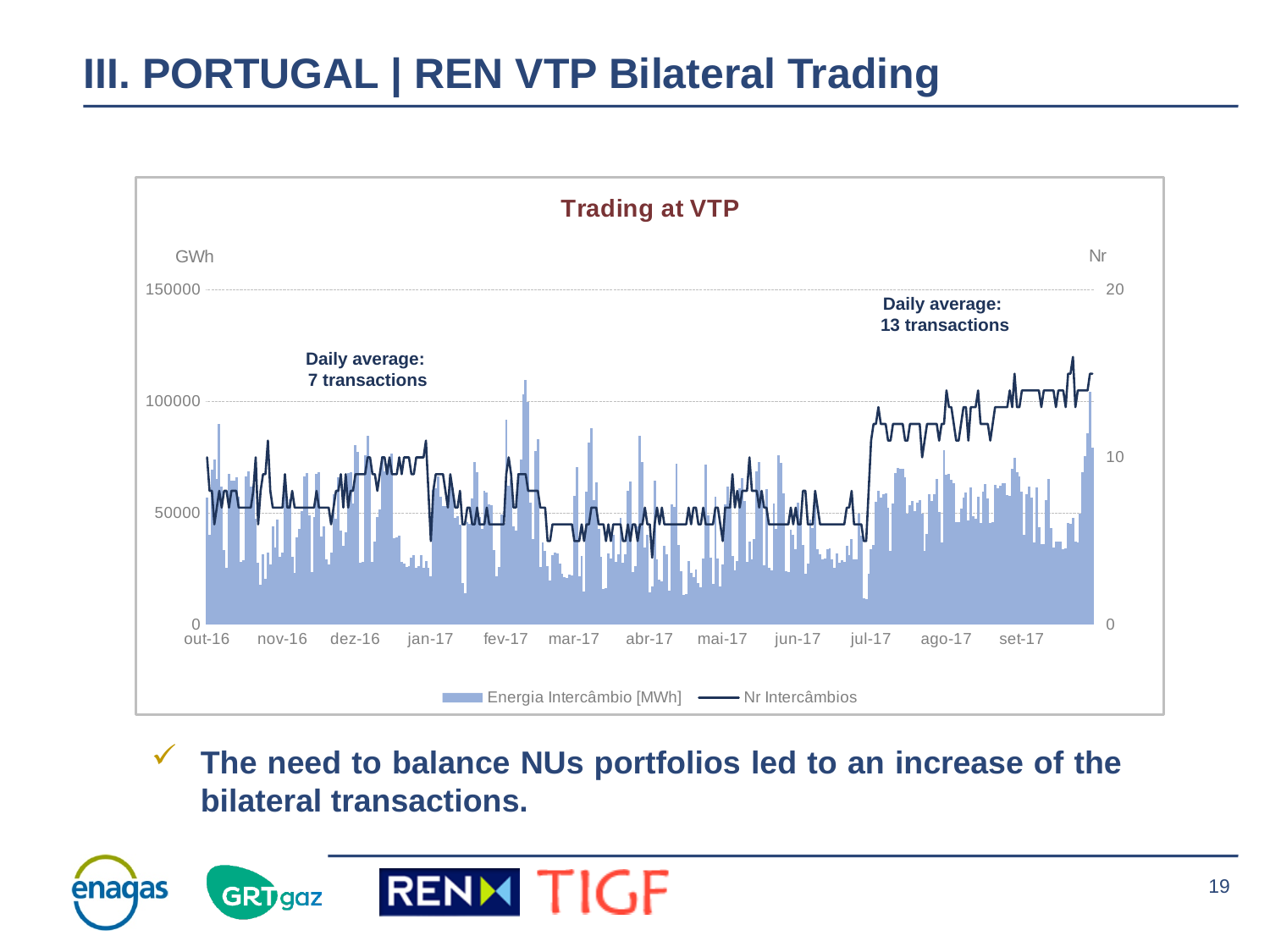
How many series does the chart legend list? 2 Which series is drawn as a line in the chart? Nr Intercâmbios What kind of chart is shown on the slide? Combined bar and line chart According to the annotation on the chart, what was the daily average number of transactions in the later period (around August–September 2017)? 13 transactions What is the maximum value shown on the right (Nr) axis of the chart? 20 According to the annotation on the chart, what was the daily average number of transactions in the earlier period (around late 2016)? 7 transactions What is the title of the chart? Trading at VTP How many month labels are shown on the x axis of the chart? 12 Is the Nr Intercâmbios line in ago-17 greater or less than 10 on the right axis? greater What is the maximum value shown on the left (GWh) axis of the chart? 150000 Is the Nr Intercâmbios line in mar-17 greater or less than 10 on the right axis? less Does the Nr Intercâmbios line generally rise or fall from jul-17 to set-17 compared with the earlier months? Rise